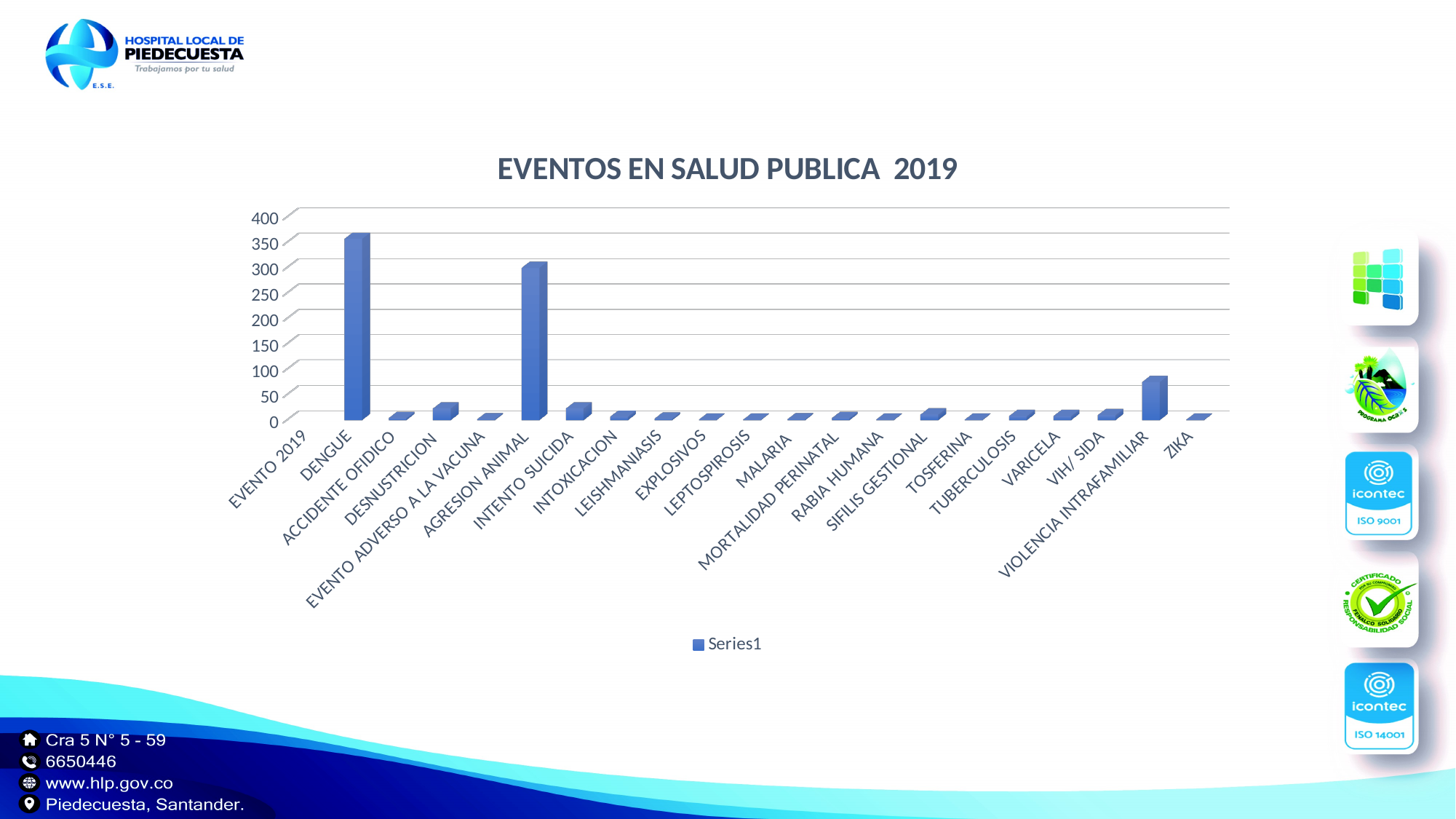
How many series does the legend list? 1 Is the value for DENGUE greater or less than 300? greater How many categories are shown on the x axis? 21 Which category has the highest value? DENGUE Is the value for DESNUTRICION greater or less than 50? less Which is larger, the value for DENGUE or the value for AGRESION ANIMAL? DENGUE What is the name of the series shown in the legend? Series1 Is the value for AGRESION ANIMAL greater or less than 350? less Which is larger, the value for VIOLENCIA INTRAFAMILIAR or the value for DESNUTRICION? VIOLENCIA INTRAFAMILIAR What is the title of the chart? EVENTOS EN SALUD PUBLICA 2019 What kind of chart is shown on the slide? bar chart